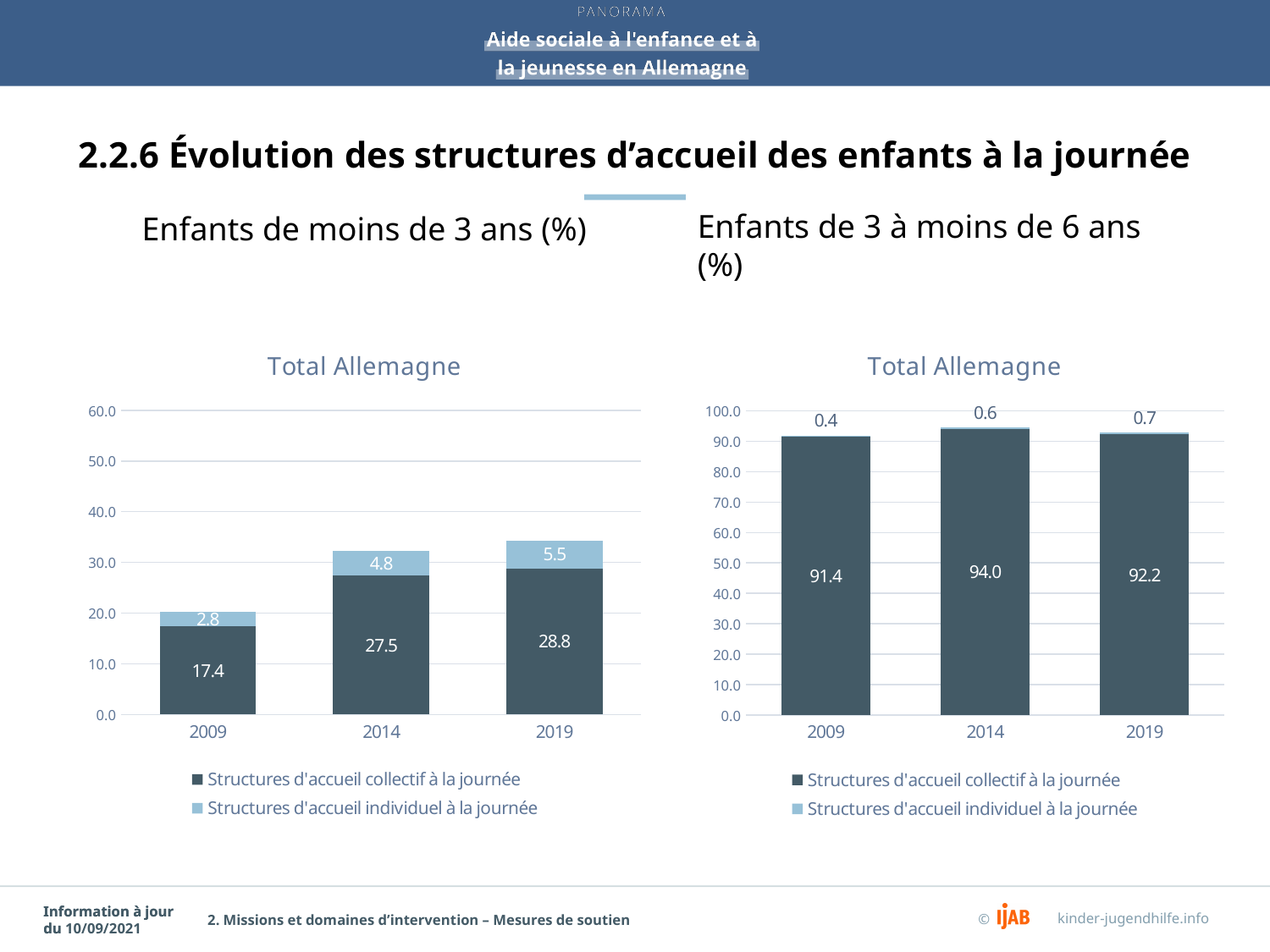
In the right chart (Enfants de 3 à moins de 6 ans), which year has the lowest value for Structures d'accueil collectif à la journée? 2009 In the left chart (Enfants de moins de 3 ans), what is the total of the stacked bar for 2014? 32.3 In the left chart (Enfants de moins de 3 ans), which year has the highest value for Structures d'accueil collectif à la journée? 2019 In the left chart (Enfants de moins de 3 ans), what is the value for Structures d'accueil individuel à la journée in 2019? 5.5 In the left chart (Enfants de moins de 3 ans), what is the value for Structures d'accueil collectif à la journée in 2009? 17.4 In the right chart (Enfants de 3 à moins de 6 ans), what is the value for Structures d'accueil collectif à la journée in 2014? 94.0 In the left chart (Enfants de moins de 3 ans), what is the difference between the Structures d'accueil collectif à la journée values for 2014 and 2009? 10.1 In the right chart (Enfants de 3 à moins de 6 ans), what is the total of the stacked bar for 2019? 92.9 In the right chart (Enfants de 3 à moins de 6 ans), is the value for Structures d'accueil collectif à la journée in 2014 larger or smaller than in 2019? larger What kind of chart is the right chart (Enfants de 3 à moins de 6 ans)? Stacked bar chart In the right chart (Enfants de 3 à moins de 6 ans), what is the value for Structures d'accueil individuel à la journée in 2009? 0.4 How many series does the legend of the left chart (Enfants de moins de 3 ans) list? 2